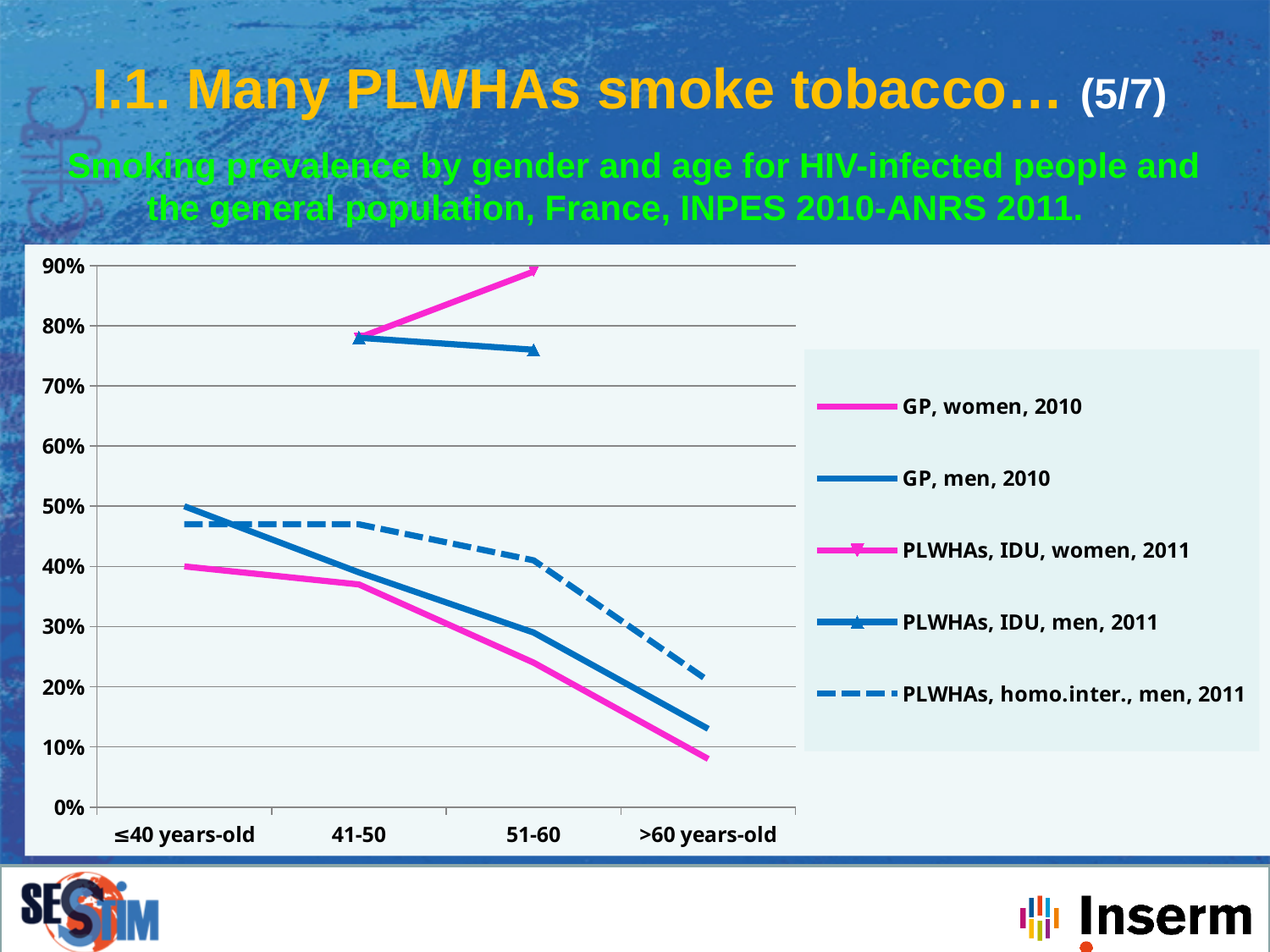
Is the value for PLWHAs, homo.inter., men, 2011 at 51-60 greater or less than 50%? less Does the value for GP, men, 2010 rise or fall from ≤40 years-old to >60 years-old? fall How many age categories are shown on the x axis? 4 Which series is drawn with a dashed line? PLWHAs, homo.inter., men, 2011 Which series has the lowest value at >60 years-old? GP, women, 2010 What kind of chart is shown on the slide? line chart Does the value for PLWHAs, IDU, women, 2011 rise or fall from 41-50 to 51-60? rise Which series has the highest value at 51-60? PLWHAs, IDU, women, 2011 Is the value for GP, women, 2010 at >60 years-old greater or less than 10%? less Is the value for PLWHAs, IDU, women, 2011 at 51-60 greater or less than 80%? greater At 41-50, which is larger: the value for GP, men, 2010 or the value for GP, women, 2010? GP, men, 2010 How many series does the legend list? 5